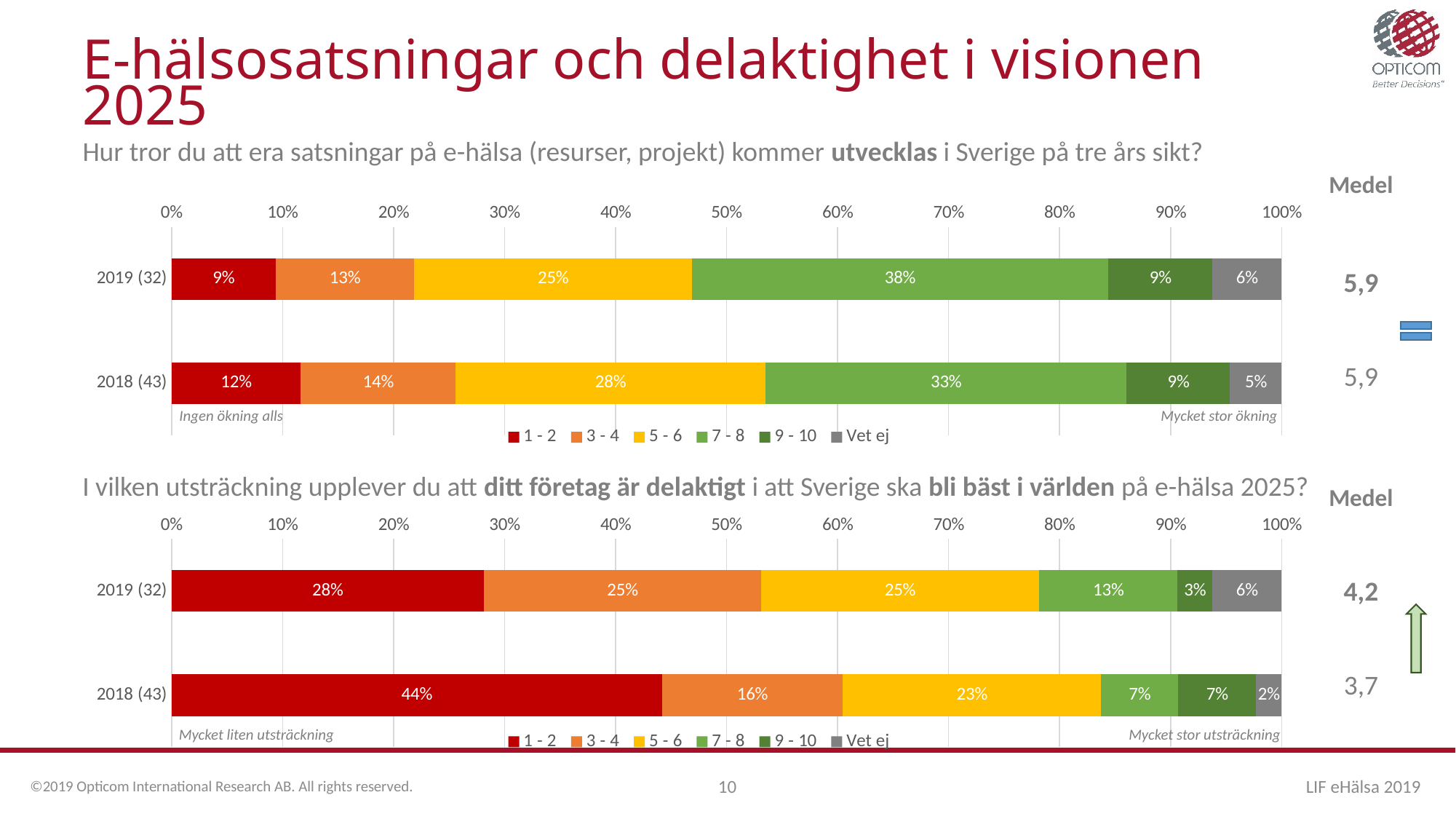
In the bottom chart, what percentage of 2019 (32) respondents answered 9 - 10? 3% In the top chart, what percentage of 2019 (32) respondents answered 7 - 8? 38% How many series does the legend of the top chart list? 6 In the bottom chart, what is the difference between the 1 - 2 share for 2018 (43) and for 2019 (32)? 16% In the top chart, which is larger: the 7 - 8 share for 2019 (32) or for 2018 (43)? 2019 (32) In the bottom chart, which response category has the smallest share for 2018 (43)? Vet ej In the top chart, which response category has the largest share for 2019 (32)? 7 - 8 In the top chart, what percentage of 2018 (43) respondents answered 5 - 6? 28% How many bars (years) are shown in the bottom chart? 2 What kind of chart is the top chart? Stacked bar chart What is the Medel (mean) value shown for 2019 (32) in the bottom chart? 4,2 In the bottom chart, what percentage of 2018 (43) respondents answered 1 - 2? 44%